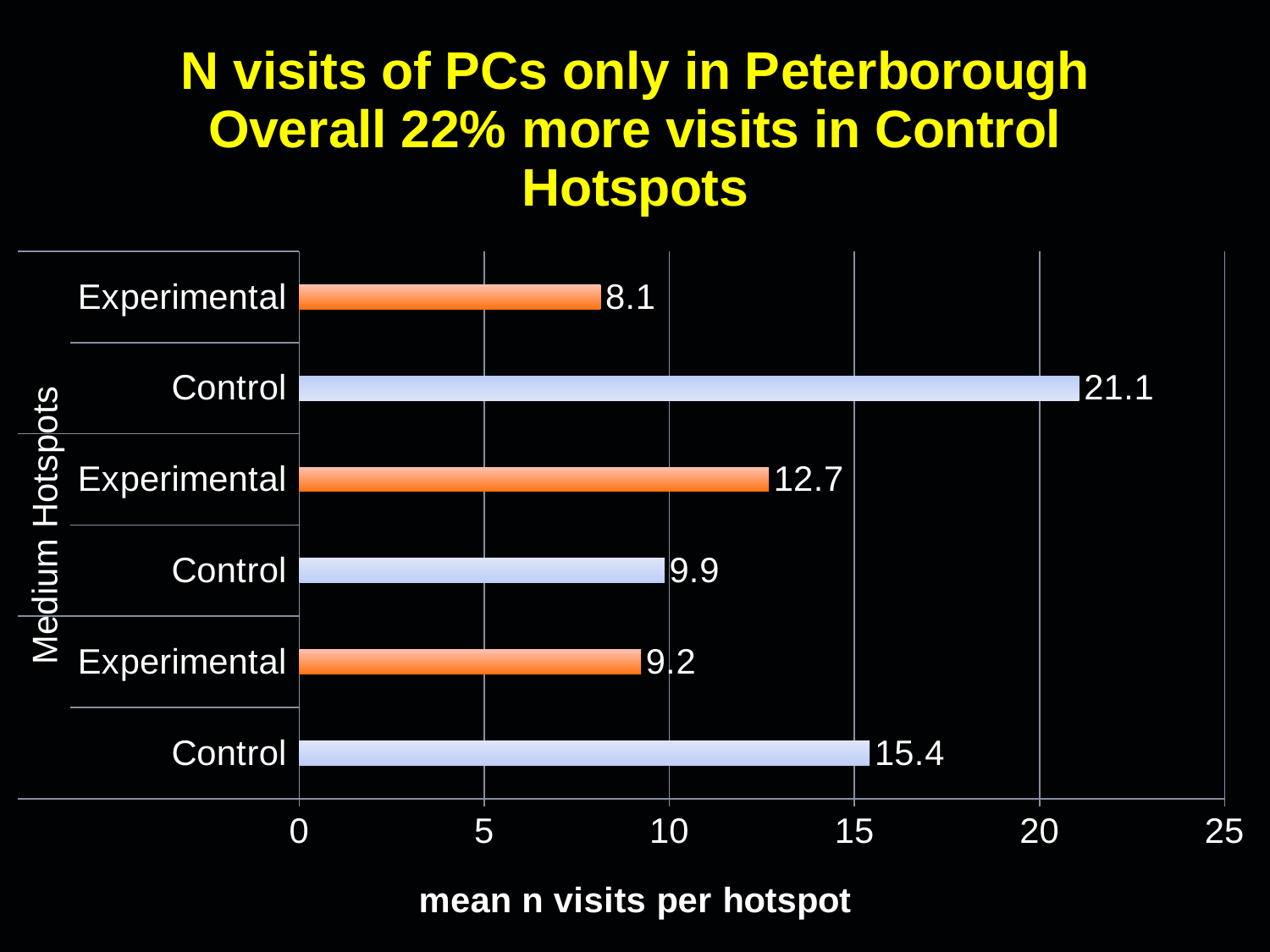
Which bar has the lowest value on the chart? Experimental (top), 8.1 What is the value of the topmost Experimental bar? 8.1 What is the difference between the Control bar second from the top (21.1) and the Experimental bar at the top (8.1)? 13 Which is larger: the Control bar fourth from the top (9.9) or the Experimental bar fifth from the top (9.2)? Control, 9.9 How many bars are plotted on the chart? 6 Which bar has the highest value on the chart? Control (second from top), 21.1 What type of chart is shown on the slide? bar chart What is the label of the horizontal axis? mean n visits per hotspot What is the value of the Control bar that is second from the top? 21.1 What is the maximum value shown on the horizontal axis? 25 What is the value of the Experimental bar in the middle of the chart (third from the top)? 12.7 What is the value of the bottom Control bar? 15.4